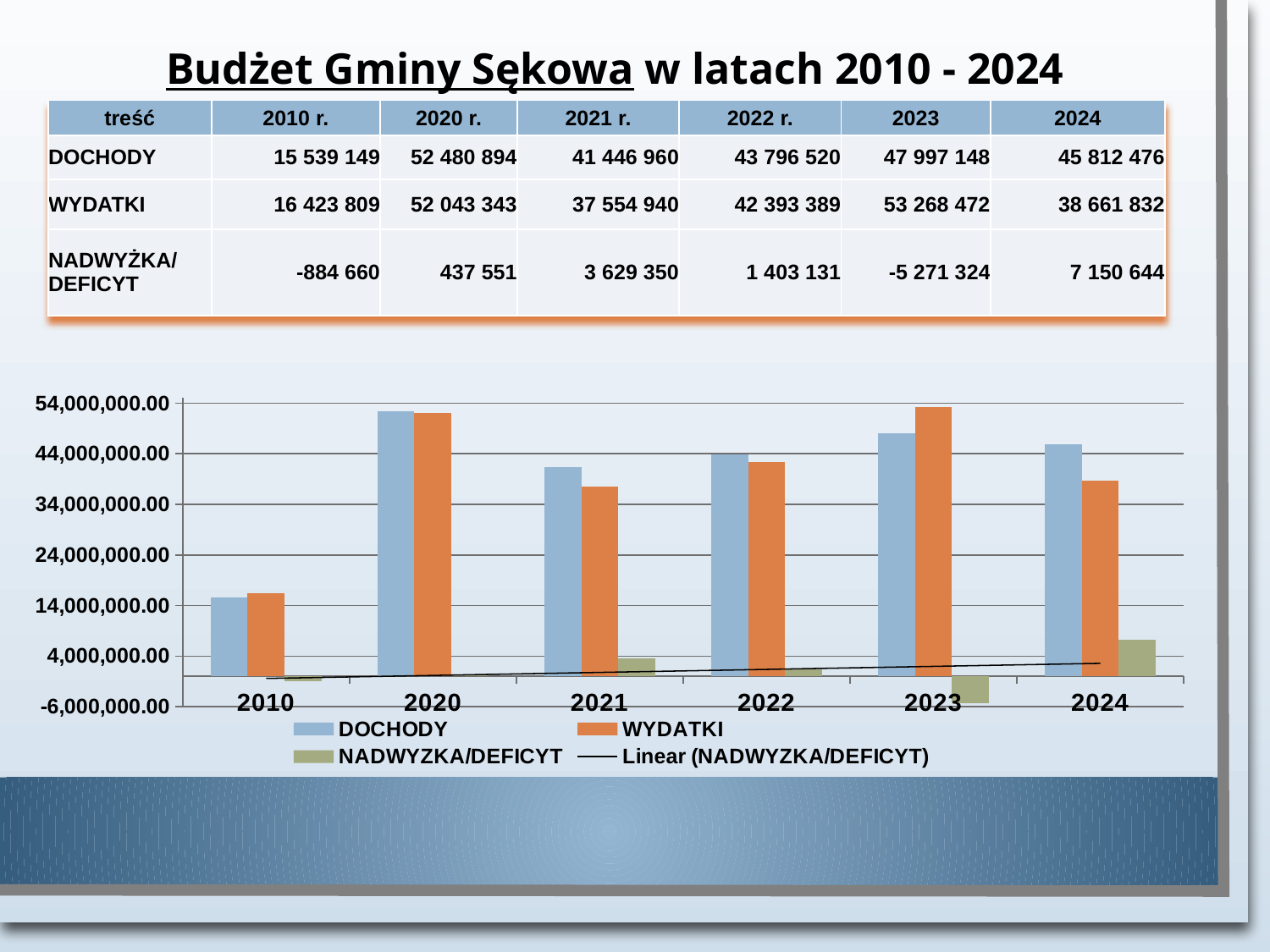
What is the difference between DOCHODY and WYDATKI in 2024? 7 150 644 In which year is the NADWYZKA/DEFICYT bar the lowest? 2023 Which series is shown in orange in the chart? WYDATKI How many entries does the chart legend list? 4 What is the value of DOCHODY for 2021? 41 446 960 What kind of chart is shown on the slide? bar chart In which year is the DOCHODY bar the highest? 2020 How many years (categories) are shown on the x axis of the chart? 6 In 2023, which is larger, DOCHODY or WYDATKI? WYDATKI What is the value of WYDATKI for 2023? 53 268 472 Is the WYDATKI value for 2021 greater or less than 34,000,000.00? greater In which year is the DOCHODY bar the lowest? 2010